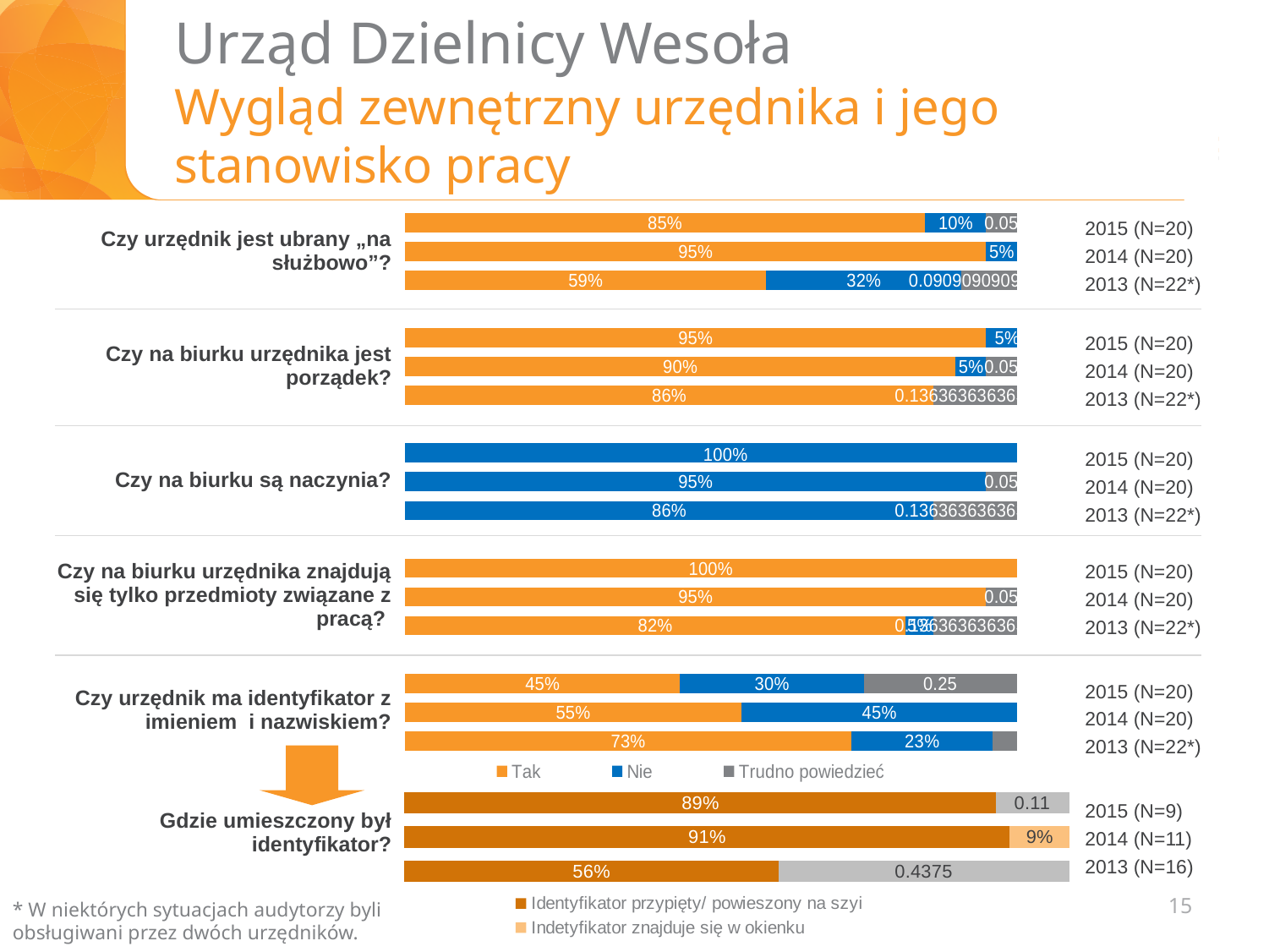
In the chart "Czy urzędnik ma identyfikator z imieniem i nazwiskiem?", what is the value for Nie in 2015 (N=20)? 30% In the chart "Czy urzędnik jest ubrany „na służbowo”?", which year has the highest Tak value? 2014 (N=20) In the chart "Czy na biurku urzędnika jest porządek?", what is the value for Tak in 2014 (N=20)? 90% In the chart "Czy na biurku urzędnika znajdują się tylko przedmioty związane z pracą?", what is the value for Tak in 2013 (N=22*)? 82% What type of chart is used on this slide? Stacked bar chart In the chart "Czy na biurku urzędnika jest porządek?", what is the difference between the Tak values for 2015 (N=20) and 2013 (N=22*)? 9 percentage points In the chart "Czy na biurku są naczynia?", what is the value for Nie in 2015 (N=20)? 100% In the chart "Gdzie umieszczony był identyfikator?", what is the value for "Identyfikator przypięty/ powieszony na szyi" in 2014 (N=11)? 91% In the chart "Czy urzędnik jest ubrany „na służbowo”?", what is the value for Tak in 2015 (N=20)? 85% How many series does the legend with Tak, Nie and Trudno powiedzieć list? 3 In the chart "Czy urzędnik jest ubrany „na służbowo”?", what is the value for Nie in 2013 (N=22*)? 32% In the chart "Czy urzędnik ma identyfikator z imieniem i nazwiskiem?", which is larger in 2014 (N=20): Tak or Nie? Tak